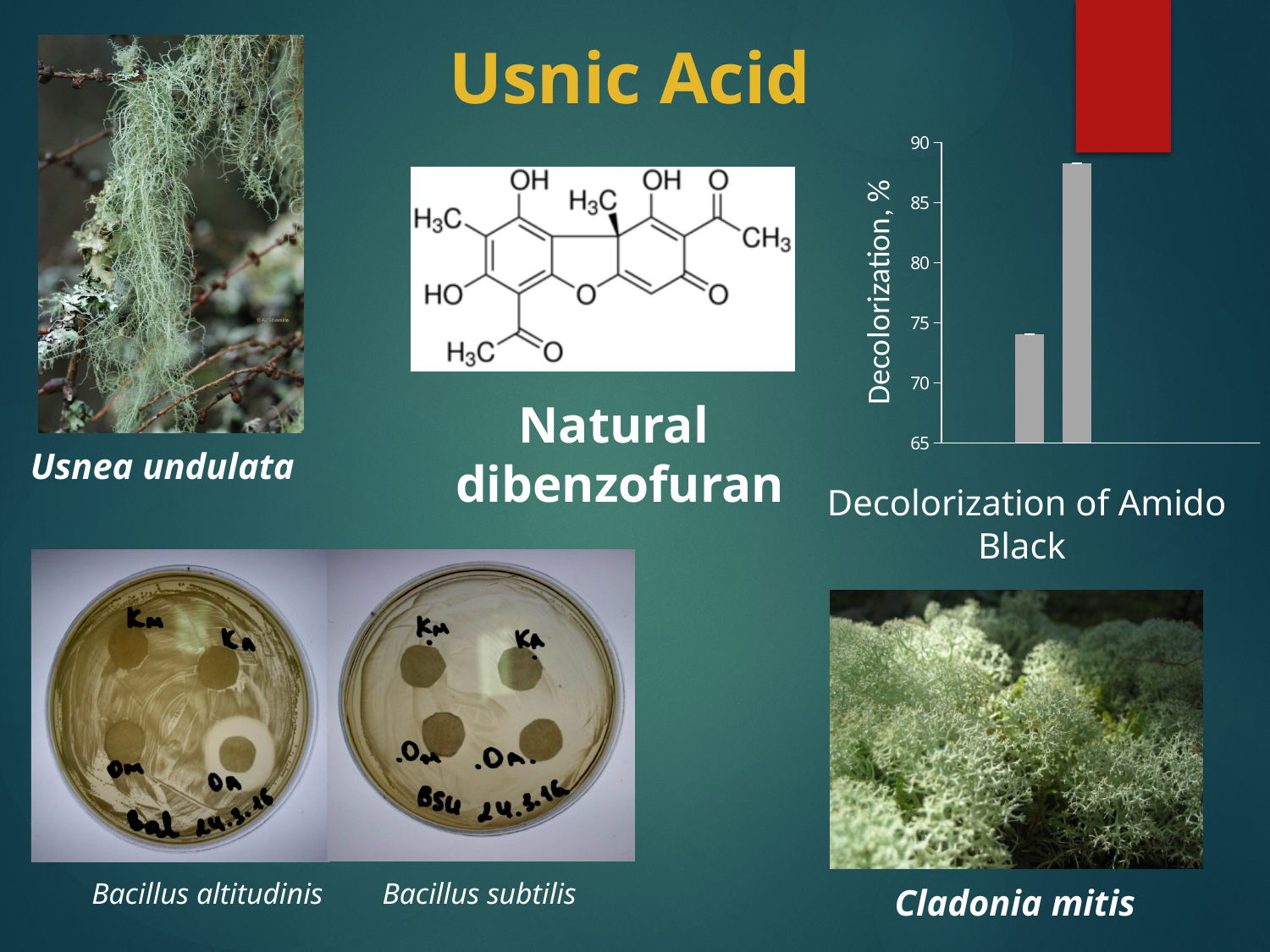
In the decolorization chart, is the value of the right bar greater or less than 85? greater In the decolorization chart, is the value of the left bar greater or less than 75? less How many bars are plotted in the decolorization chart? 2 What caption appears below the decolorization chart? Decolorization of Amido Black What is the label on the vertical axis of the decolorization chart? Decolorization, % What is the lowest value shown on the vertical axis of the decolorization chart? 65 In the decolorization chart, is the value of the right bar greater or less than 90? less Do the bar values in the decolorization chart rise or fall from left to right? rise What kind of chart is shown under the title 'Usnic Acid' on the right of the slide? bar chart In the decolorization chart, which bar is taller, the left bar or the right bar? the right bar